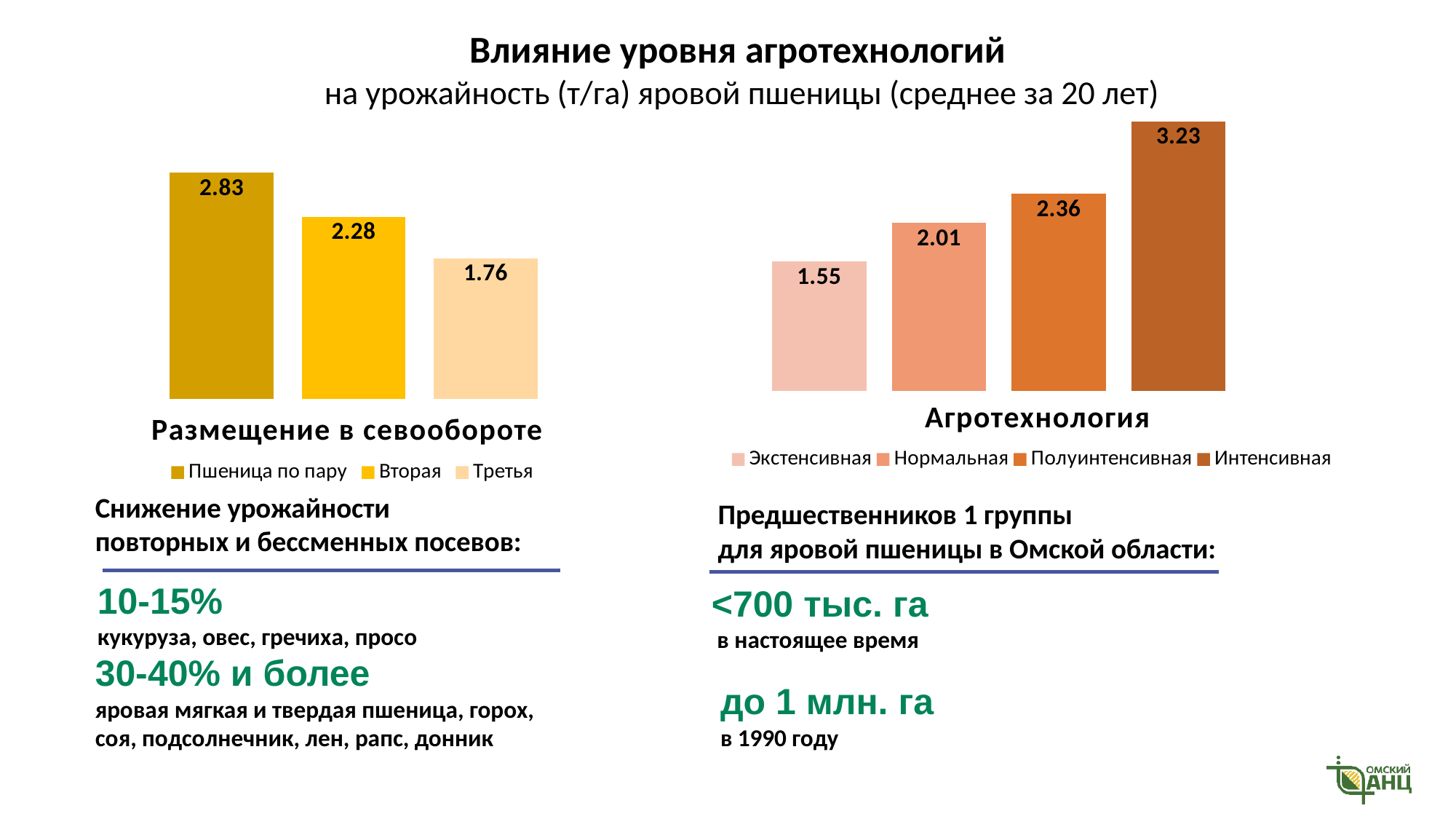
In the chart 'Размещение в севообороте', what is the difference between 'Пшеница по пару' and 'Вторая'? 0.55 In the chart 'Размещение в севообороте', what is the value for 'Третья'? 1.76 In the chart 'Агротехнология', what is the value for 'Интенсивная'? 3.23 In the chart 'Агротехнология', which category has the highest value? Интенсивная In the chart 'Агротехнология', what is the value for 'Нормальная'? 2.01 In the chart 'Агротехнология', what is the difference between 'Интенсивная' and 'Экстенсивная'? 1.68 In the chart 'Агротехнология', which is larger: 'Полуинтенсивная' or 'Нормальная'? Полуинтенсивная In the chart 'Размещение в севообороте', what is the value for 'Пшеница по пару'? 2.83 In the chart 'Размещение в севообороте', which category has the lowest value? Третья In the chart 'Размещение в севообороте', how many entries does the legend list? 3 What kind of chart is the chart 'Агротехнология'? bar chart In the chart 'Агротехнология', do the values rise or fall from left to right? rise